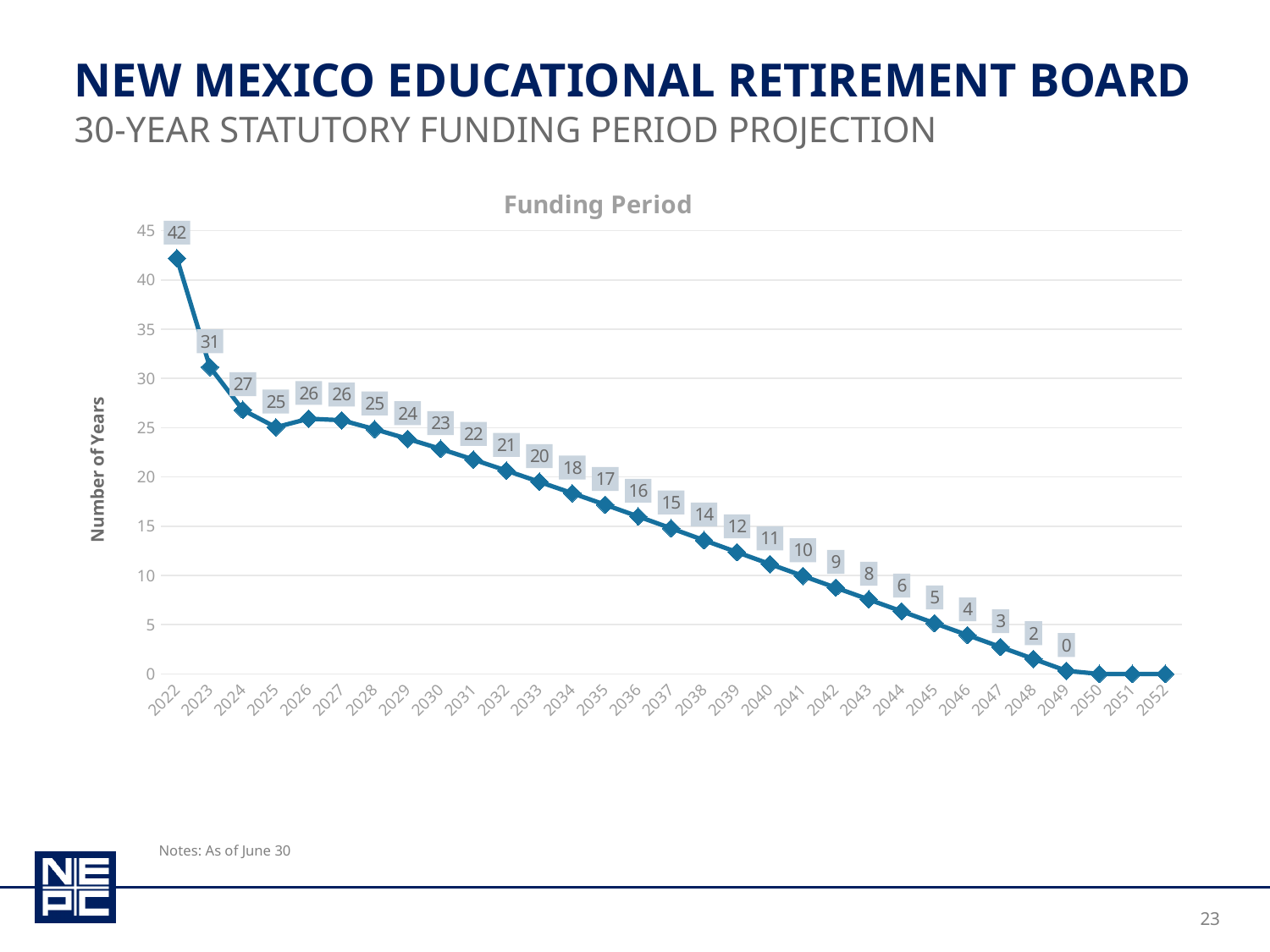
What is the y-axis label of the Funding Period chart? Number of Years What is the value for 2030 in the Funding Period chart? 23 Which is larger in the Funding Period chart, the value for 2026 or the value for 2028? 2026 Do the values in the Funding Period chart generally rise or fall from 2022 to 2052? fall What is the difference between the values for 2033 and 2043 in the Funding Period chart? 12 What kind of chart is the Funding Period chart? line chart How many years are plotted on the x axis of the Funding Period chart? 31 What is the difference between the values for 2022 and 2023 in the Funding Period chart? 11 What is the value for 2045 in the Funding Period chart? 5 Is the value for 2023 in the Funding Period chart greater or less than 30? greater What is the value for 2022 in the Funding Period chart? 42 Which year has the highest value in the Funding Period chart? 2022